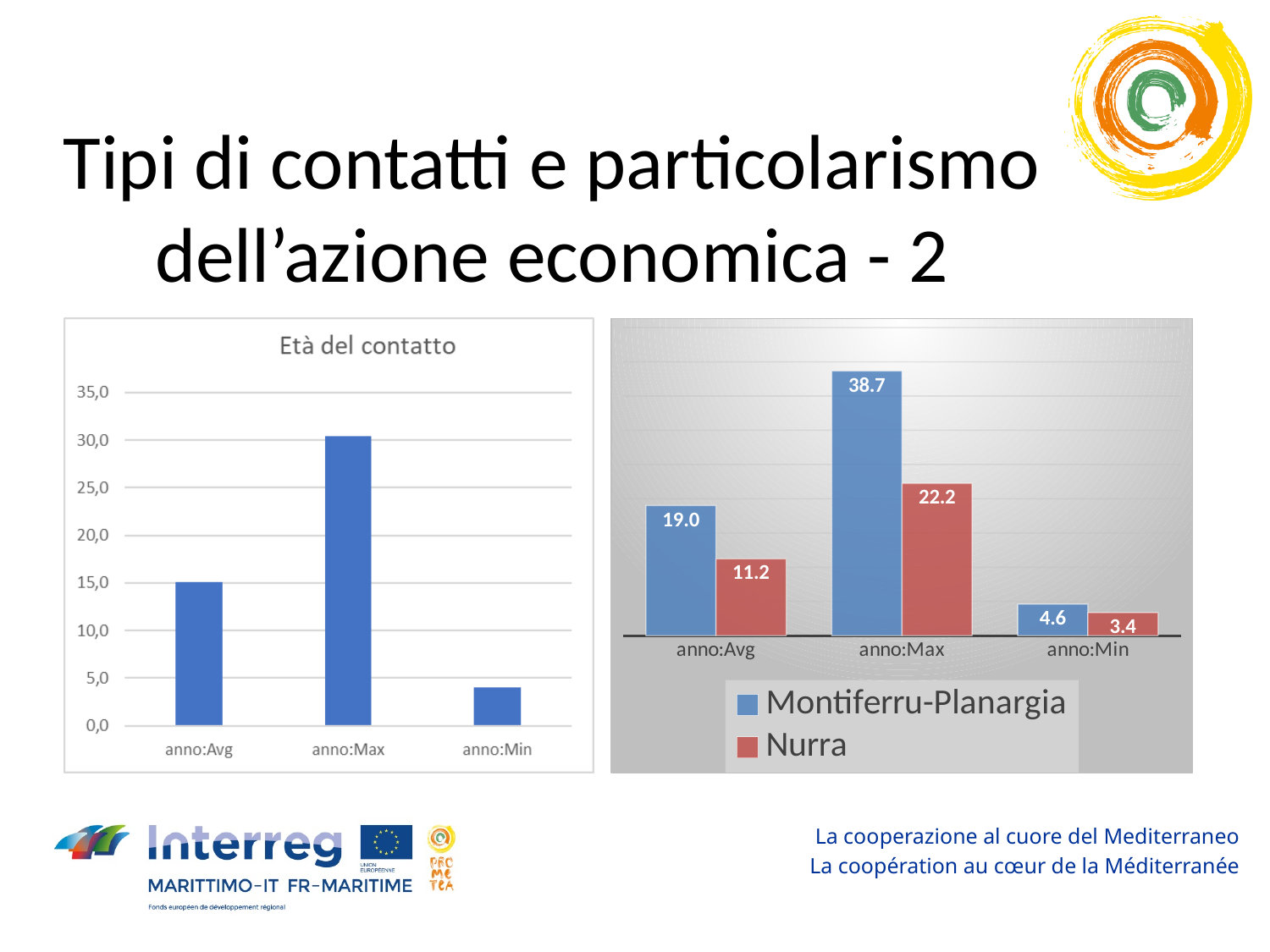
In the chart titled "Età del contatto" on the left, which category has the highest bar? anno:Max In the chart on the right, what is the value for Montiferru-Planargia at anno:Max? 38.7 In the chart titled "Età del contatto" on the left, which category has the lowest bar? anno:Min In the chart on the right, which colour represents Nurra in the legend? red In the chart on the right, which series has the larger value at anno:Min? Montiferru-Planargia In the chart on the right, what is the difference between Montiferru-Planargia and Nurra at anno:Max? 16.5 In the chart titled "Età del contatto" on the left, is the value for anno:Max greater or less than 25,0? greater In the chart titled "Età del contatto" on the left, how many categories are shown on the x axis? 3 In the chart titled "Età del contatto" on the left, what type of chart is shown? bar chart In the chart titled "Età del contatto" on the left, is the value for anno:Avg greater or less than 20,0? less In the chart on the right, what is the value for Nurra at anno:Avg? 11.2 In the chart on the right, how many series does the legend list? 2